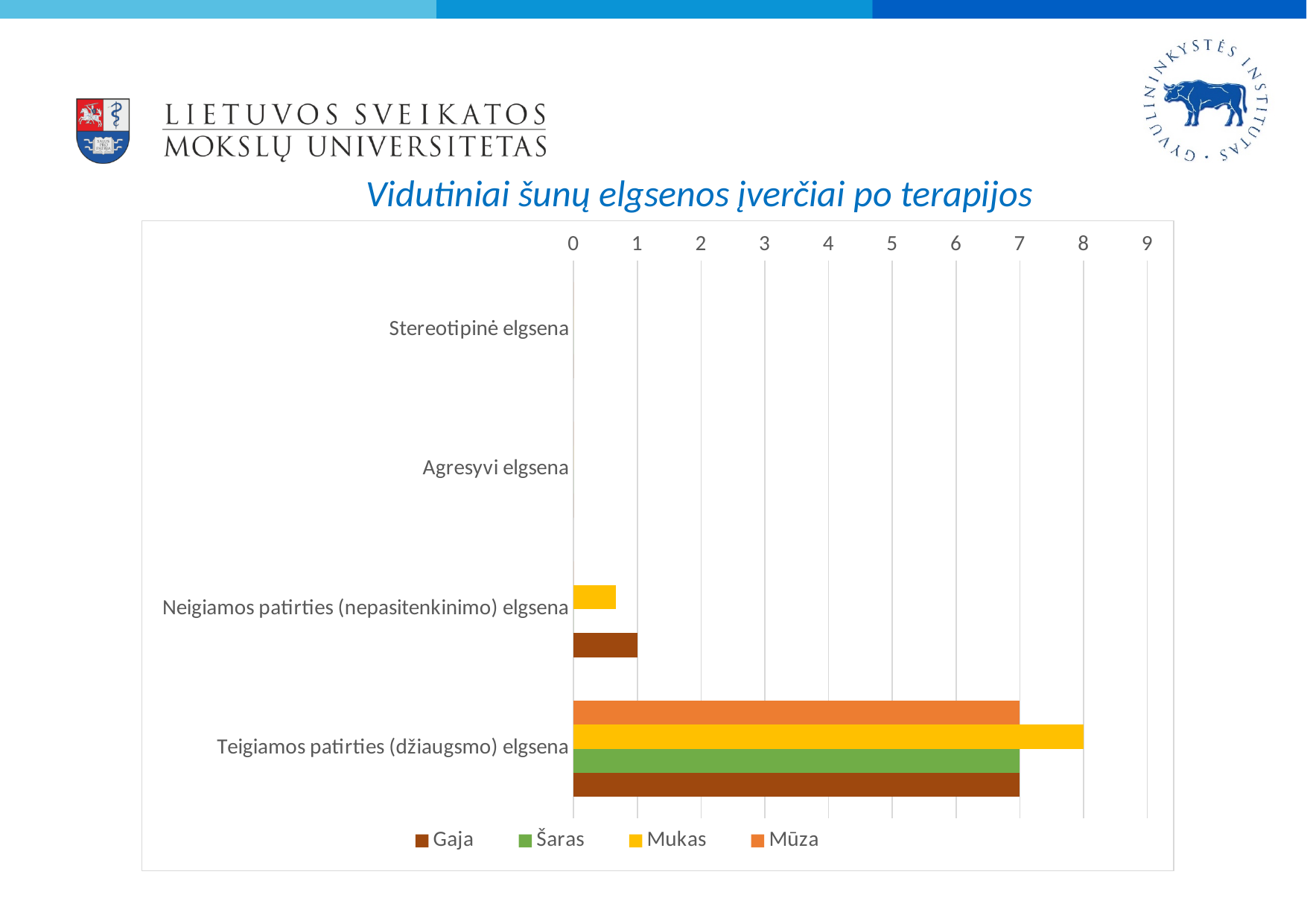
Which dog has the highest value for Teigiamos patirties (džiaugsmo) elgsena? Mukas What is the value for Mukas in the category Teigiamos patirties (džiaugsmo) elgsena? 8 What is the difference between the values for Mukas and Gaja in the category Teigiamos patirties (džiaugsmo) elgsena? 1 How many behaviour categories are shown on the vertical axis? 4 What kind of chart is shown on the slide? bar chart For Teigiamos patirties (džiaugsmo) elgsena, which is larger: the value for Mukas or the value for Gaja? Mukas Which colour represents Mukas in the chart? yellow What is the value for Gaja in the category Teigiamos patirties (džiaugsmo) elgsena? 7 What is the value for Gaja in the category Neigiamos patirties (nepasitenkinimo) elgsena? 1 Is the value for Mukas in the category Neigiamos patirties (nepasitenkinimo) elgsena greater or less than 1? less What is the title of the chart? Vidutiniai šunų elgsenos įverčiai po terapijos How many series does the legend list? 4